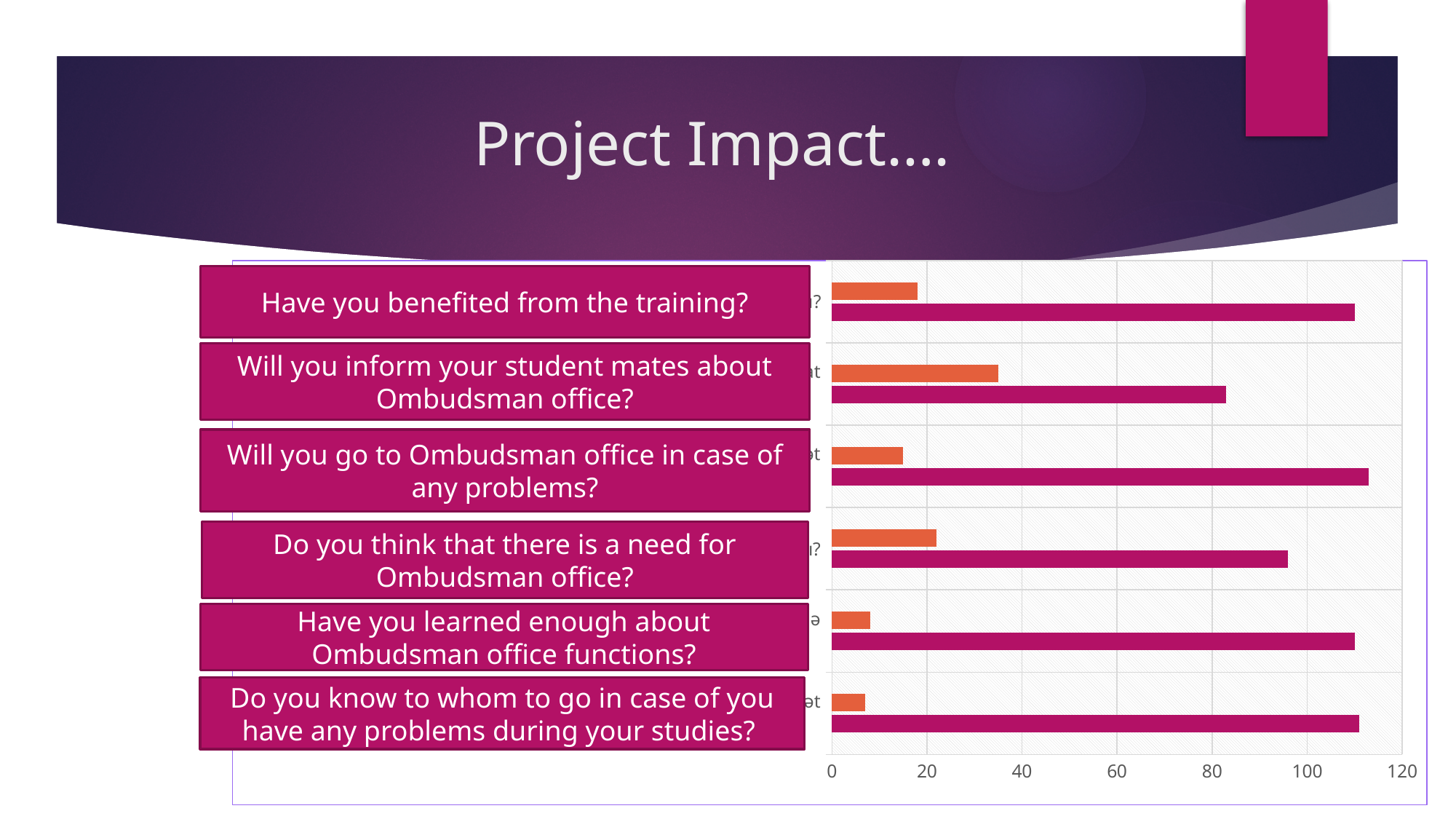
Is the orange bar for "Will you inform your student mates about Ombudsman office?" greater or less than 20? greater What kind of chart is shown on the slide? bar chart Which survey question has the longest orange bar? Will you inform your student mates about Ombudsman office? Is the orange bar for "Have you learned enough about Ombudsman office functions?" greater or less than 20? less Is the magenta bar for "Will you inform your student mates about Ombudsman office?" greater or less than 100? less Which survey question has the shortest magenta bar? Will you inform your student mates about Ombudsman office? How many survey questions (categories) are plotted on the chart? 6 What is the highest value shown on the horizontal axis of the chart? 120 For "Will you go to Ombudsman office in case of any problems?", which bar is longer, the orange or the magenta one? magenta Which orange bar is longer: "Will you inform your student mates about Ombudsman office?" or "Do you know to whom to go in case of you have any problems during your studies?"? Will you inform your student mates about Ombudsman office?